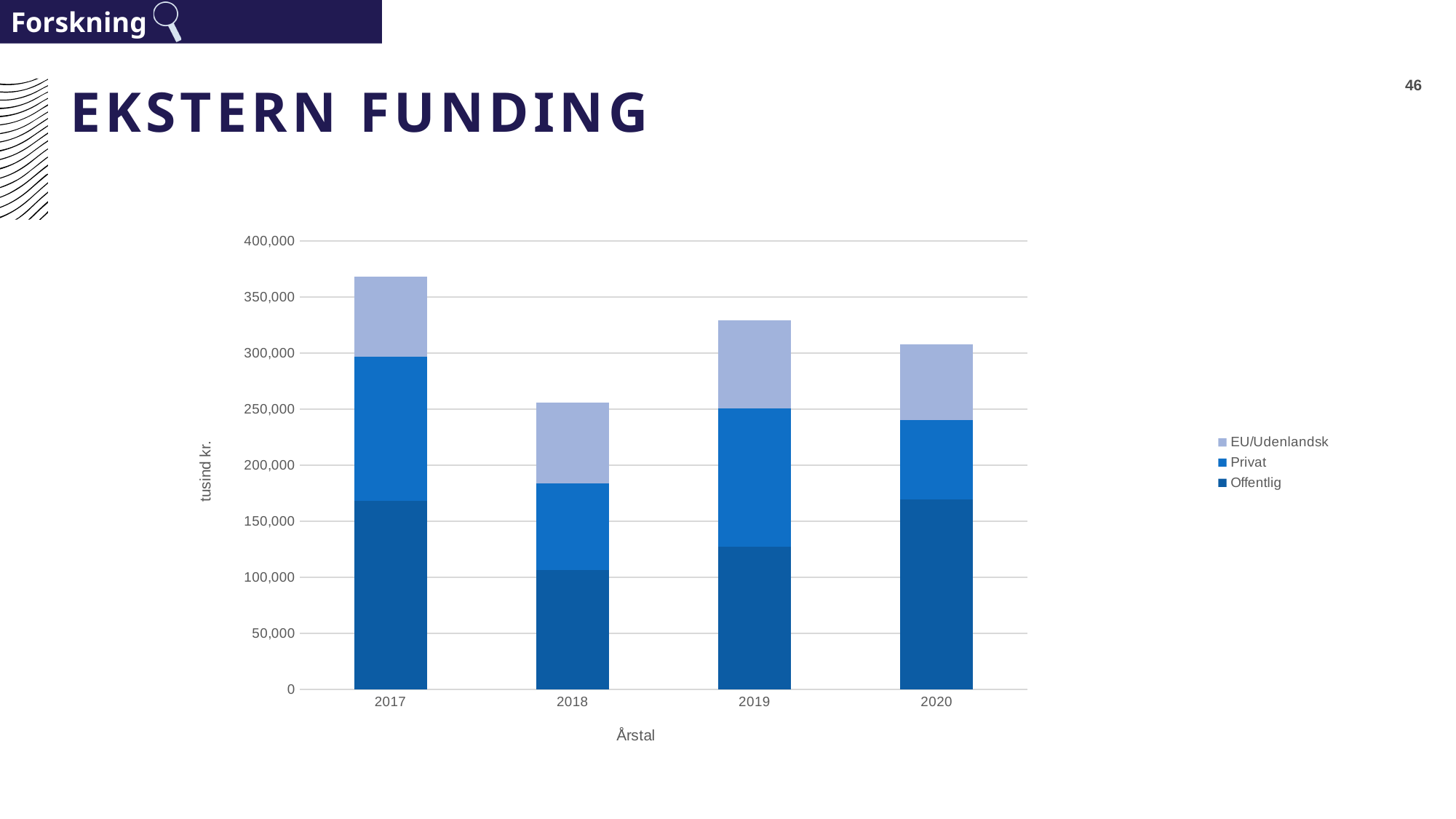
Which year has the highest total external funding? 2017 What is the label on the y axis of the chart? tusind kr. Is the total bar for 2019 greater or less than 300,000? greater Which year has the smallest Offentlig segment? 2018 Is the Offentlig segment for 2018 greater or less than 150,000? less How many years are shown on the x axis of the chart? 4 How many series does the chart's legend list? 3 Is the total bar for 2018 greater or less than 300,000? less What kind of chart is shown on the slide? Stacked bar chart Does the total external funding rise or fall from 2017 to 2018? fall Which year has the lowest total external funding? 2018